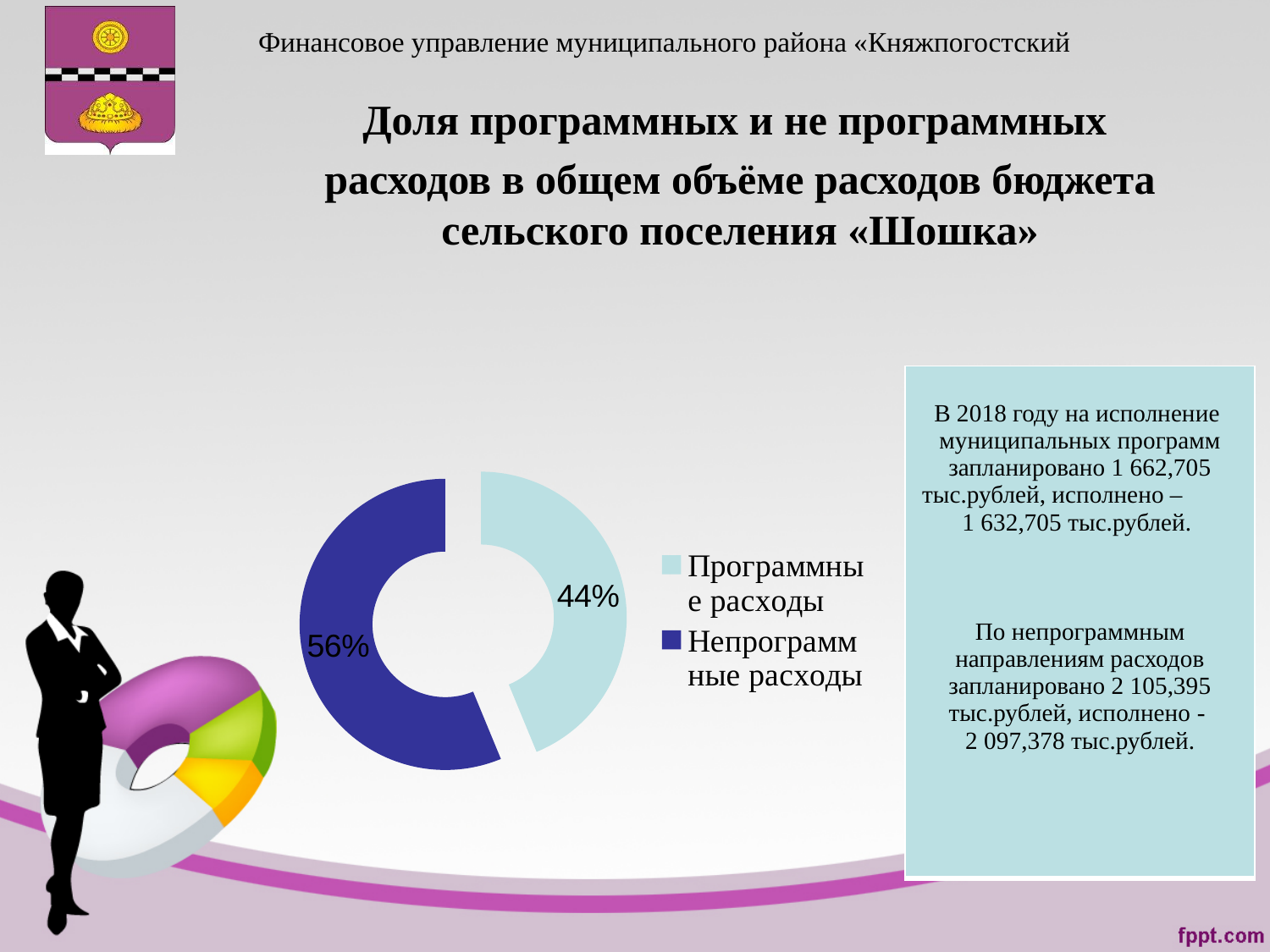
Is the share of "Непрограммные расходы" greater or less than 50%? greater Which is larger: the share of "Программные расходы" or the share of "Непрограммные расходы"? Непрограммные расходы What share of the doughnut chart is labelled "Программные расходы"? 44% Which category has the smallest share in the doughnut chart? Программные расходы What colour is the "Программные расходы" segment in the chart? Light blue Which category has the largest share in the doughnut chart? Непрограммные расходы What share of the doughnut chart is labelled "Непрограммные расходы"? 56% What is the difference in percentage points between the shares of "Непрограммные расходы" and "Программные расходы"? 12 What colour is the "Непрограммные расходы" segment in the chart? Dark blue How many categories are shown in the doughnut chart? 2 What type of chart is shown on the slide? Doughnut chart How many entries does the chart legend list? 2